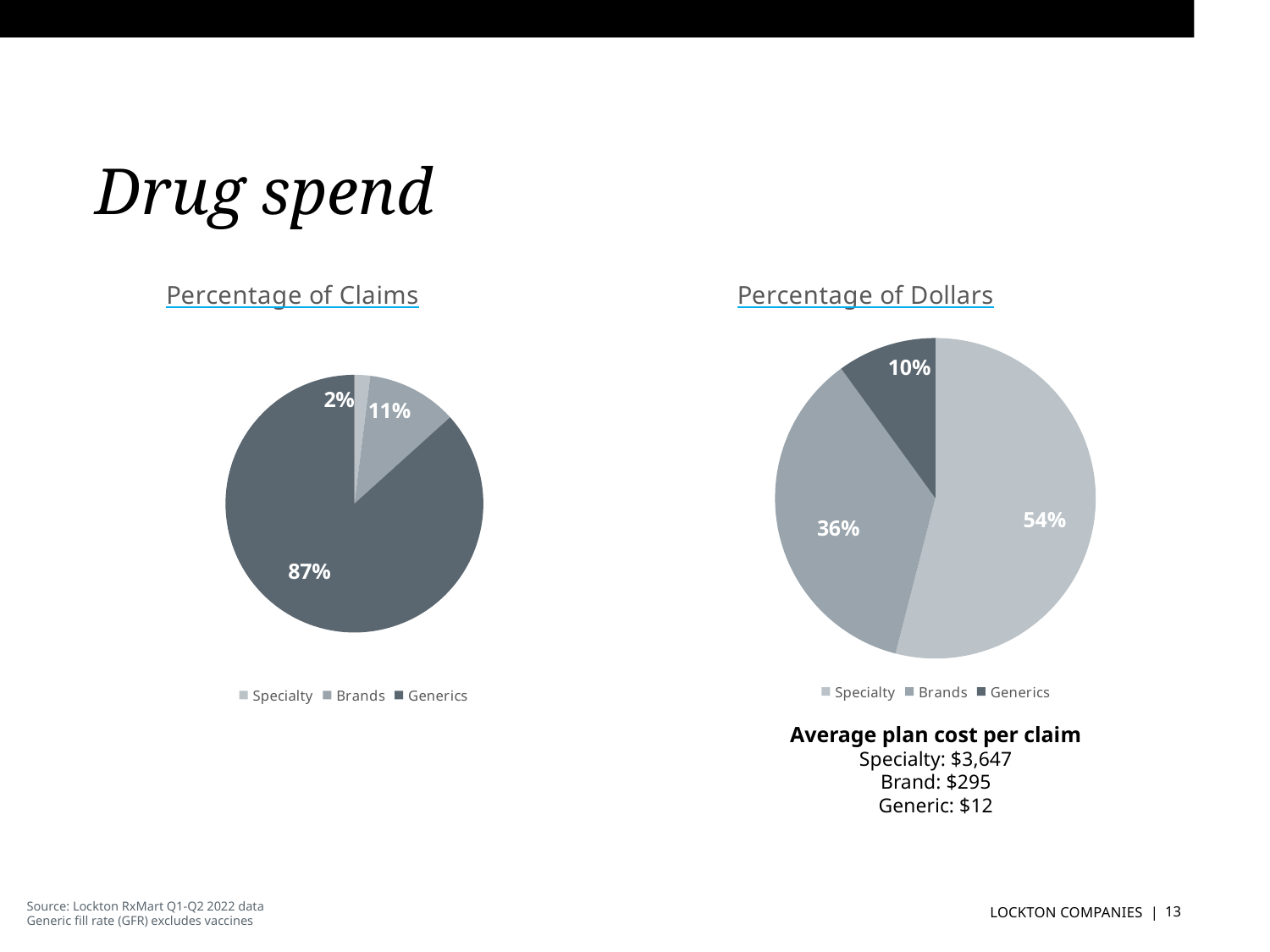
In the Percentage of Dollars chart, what share of dollars is Generics? 10% In the Percentage of Dollars chart, what share of dollars is Brands? 36% In the Percentage of Claims chart, what share of claims is Generics? 87% In the Percentage of Dollars chart, which category has the smallest slice? Generics In the Percentage of Claims chart, which is larger, the Brands slice or the Specialty slice? Brands How many categories does the legend of the Percentage of Claims chart list? 3 In the Percentage of Claims chart, what share of claims is Specialty? 2% In the Percentage of Claims chart, what share of claims is Brands? 11% In the Percentage of Dollars chart, what share of dollars is Specialty? 54% In the Percentage of Dollars chart, what is the difference between the Specialty and Brands shares? 18% In the Percentage of Claims chart, which category has the largest slice? Generics What type of chart is the Percentage of Dollars chart? Pie chart